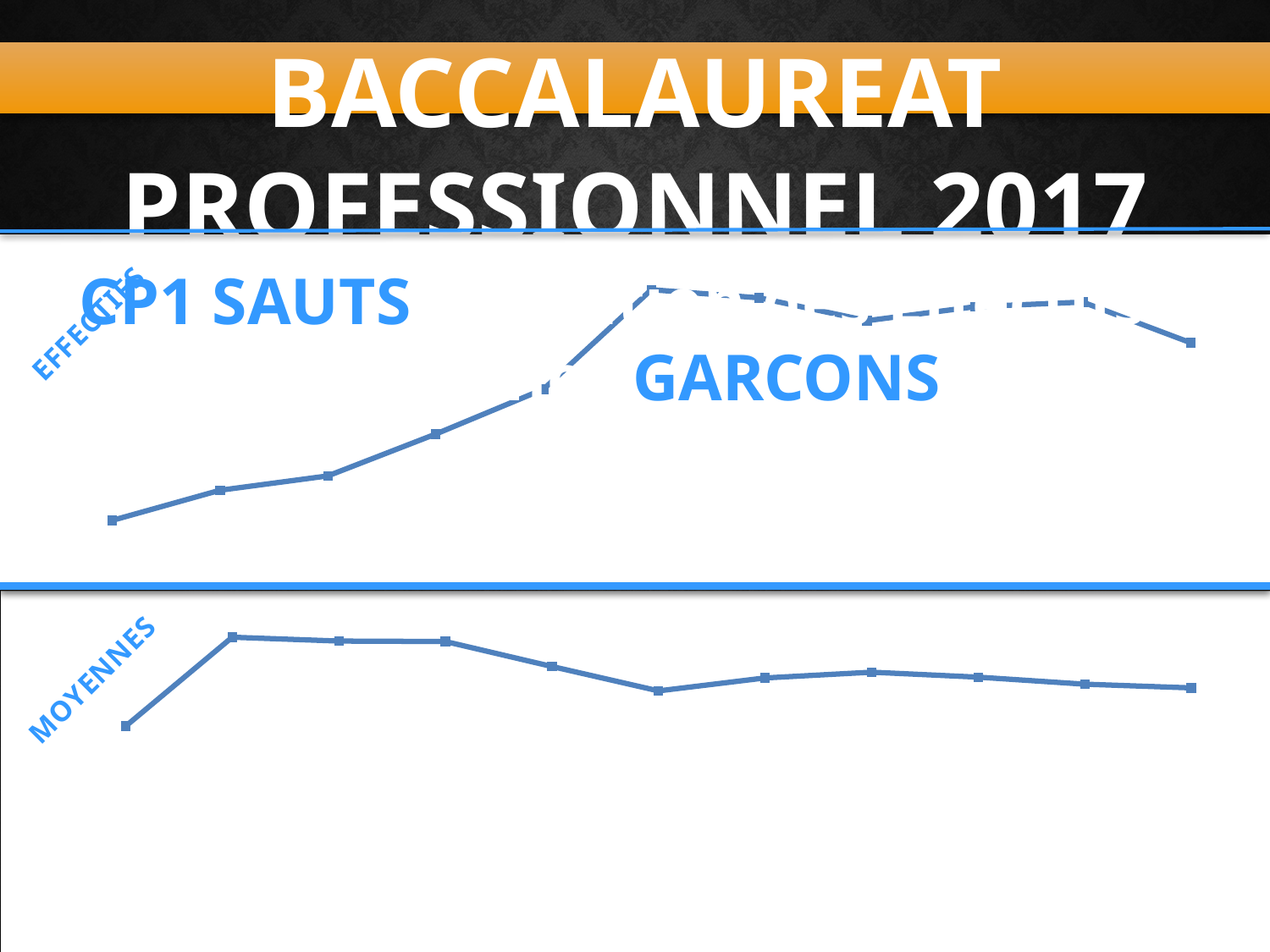
In the bottom chart labelled MOYENNES, is the first point or the second point lower? the first point In the bottom chart labelled MOYENNES, is the second point higher or lower than the sixth point? higher In the bottom chart labelled MOYENNES, do the values rise or fall between the second point and the sixth point? fall In the top chart labelled EFFECTIFS, do the values rise or fall over the first five points? rise What label is written vertically next to the top chart? EFFECTIFS What kind of chart is the bottom chart labelled MOYENNES? line chart What label is written vertically next to the bottom chart? MOYENNES In the top chart labelled EFFECTIFS, is the last point higher or lower than the first point? higher What kind of chart is the top chart labelled EFFECTIFS? line chart In the top chart labelled EFFECTIFS, which point has the lowest value, the first or the last? the first